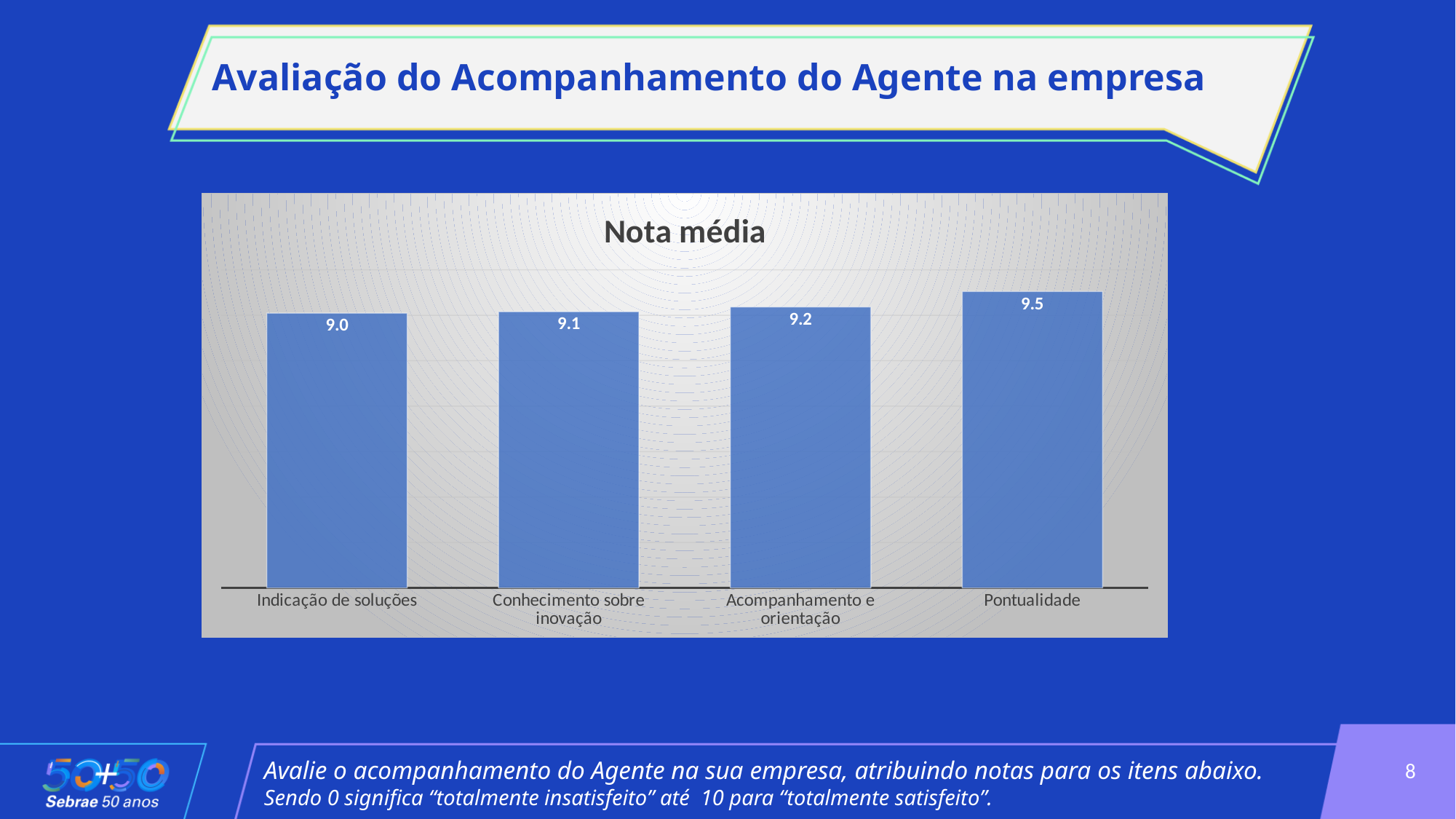
What is the average score (Nota média) for Pontualidade? 9.5 What is the title of the chart? Nota média How many items are shown in the chart? 4 What kind of chart is shown on the slide? Bar chart What is the average score for Indicação de soluções? 9.0 What is the difference between the scores for Acompanhamento e orientação and Conhecimento sobre inovação? 0.1 Which item has the lowest average score? Indicação de soluções What is the average score for Conhecimento sobre inovação? 9.1 What is the average score for Acompanhamento e orientação? 9.2 Which item has the highest average score? Pontualidade What is the difference between the scores for Pontualidade and Indicação de soluções? 0.5 Which has a higher score, Pontualidade or Acompanhamento e orientação? Pontualidade